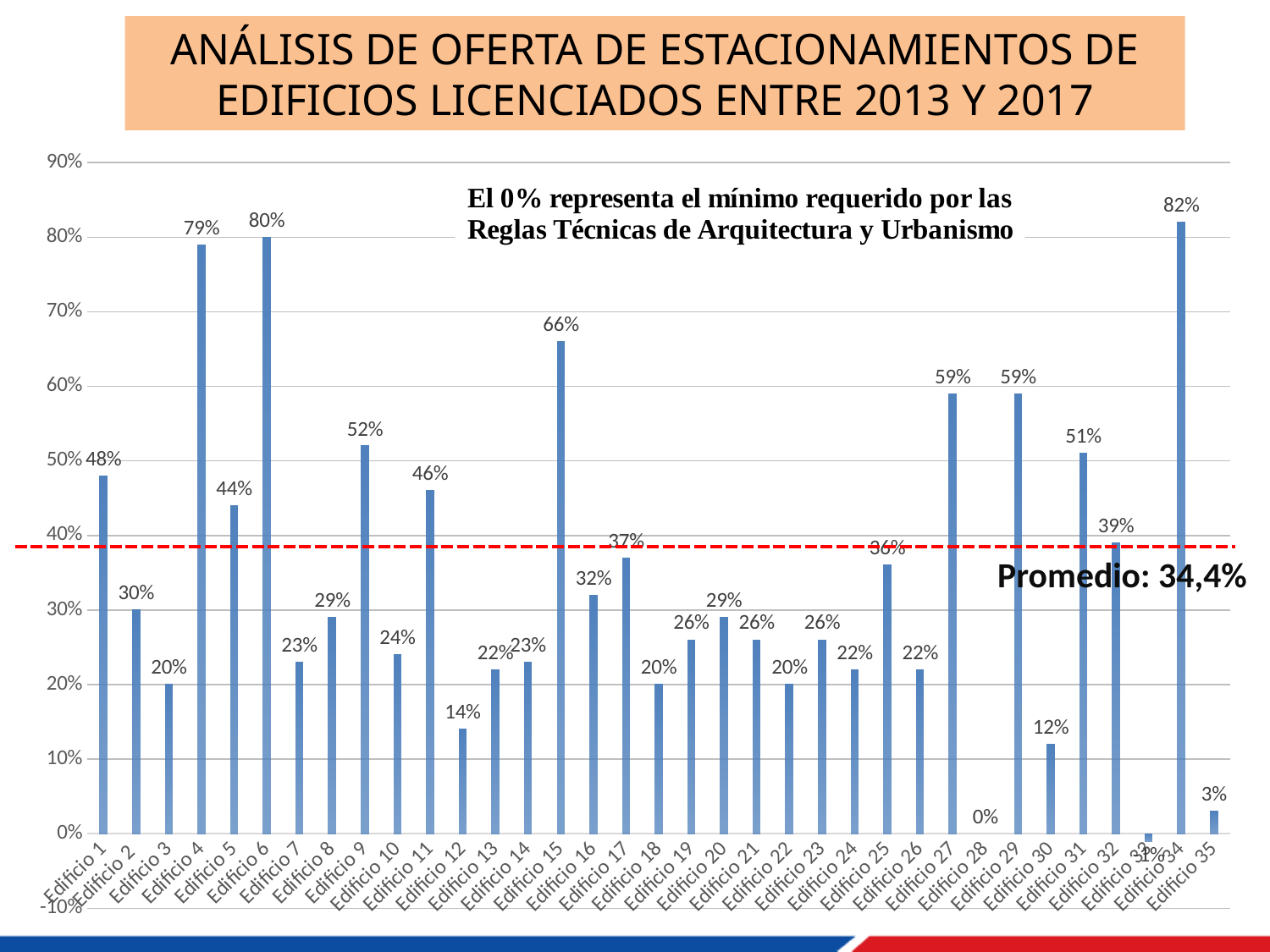
What is the difference between the values for Edificio 27 and Edificio 30? 47 percentage points Which is larger, the value for Edificio 9 or the value for Edificio 11? Edificio 9 What average (Promedio) value is printed on the chart? 34,4% Is the value for Edificio 12 greater or less than 20%? less What kind of chart is shown on the slide? Bar chart What is the difference between the values for Edificio 6 and Edificio 4? 1 percentage point What is the value for Edificio 6? 80% What is the value for Edificio 28? 0% Which building has the highest value? Edificio 34 What is the value for Edificio 15? 66% How many buildings (Edificios) are shown on the x axis? 35 What does the dashed red horizontal line represent? The average (Promedio: 34,4%)